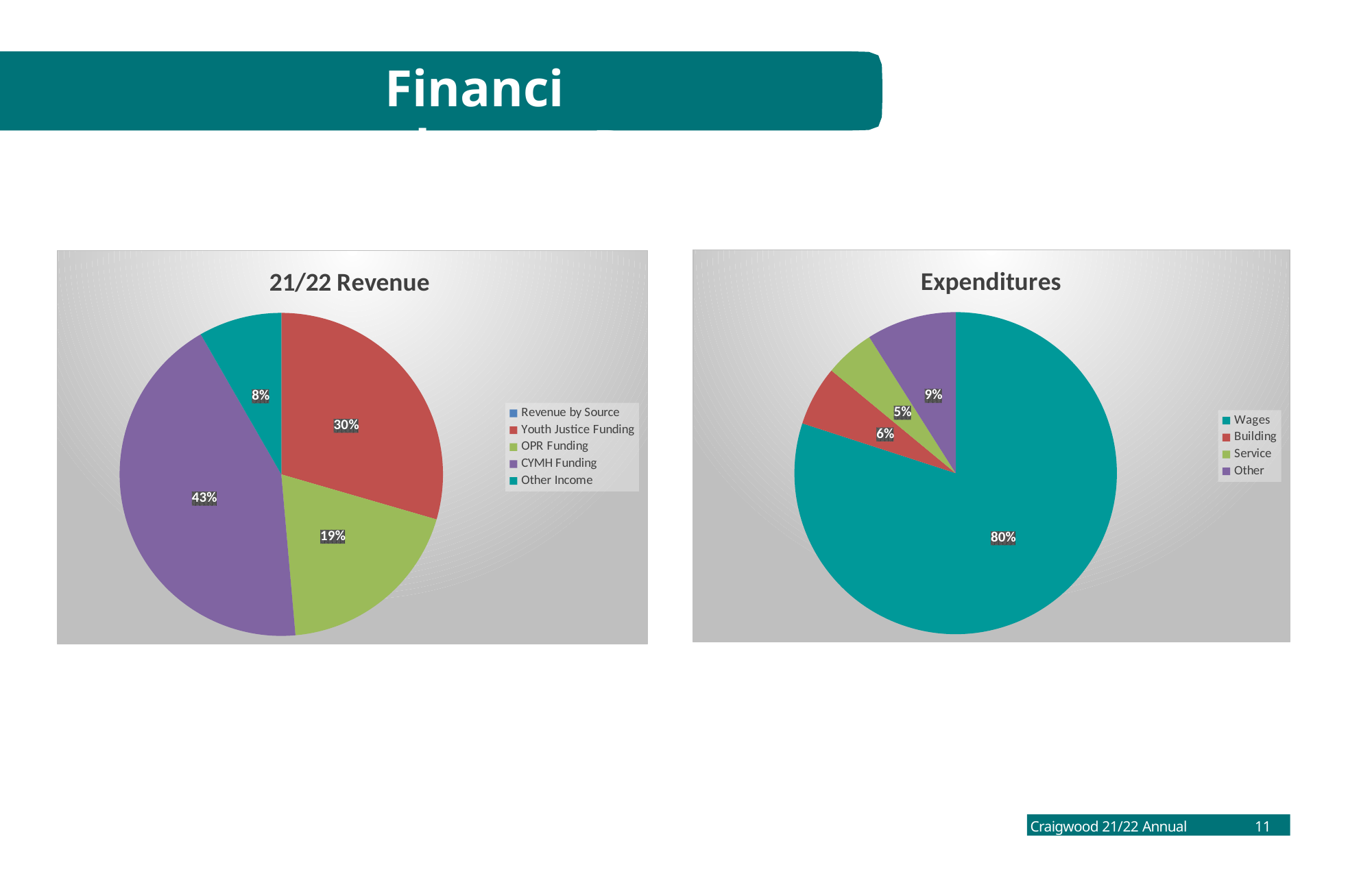
In the 21/22 Revenue chart, which source has the largest share? CYMH Funding What kind of chart is the Expenditures chart? Pie chart In the Expenditures chart, which category has the smallest share? Service In the 21/22 Revenue chart, which source has the smallest share? Other Income In the Expenditures chart, what share of expenditures is Wages? 80% In the Expenditures chart, what percentage is labelled for Building? 6% In the 21/22 Revenue chart, what percentage is labelled for Youth Justice Funding? 30% In the 21/22 Revenue chart, what is the difference in percentage points between CYMH Funding and Youth Justice Funding? 13 In the Expenditures chart, which is larger, Other or Building? Other How many entries does the legend of the Expenditures chart list? 4 In the 21/22 Revenue chart, what percentage is labelled for OPR Funding? 19% In the 21/22 Revenue chart, what share of revenue comes from CYMH Funding? 43%